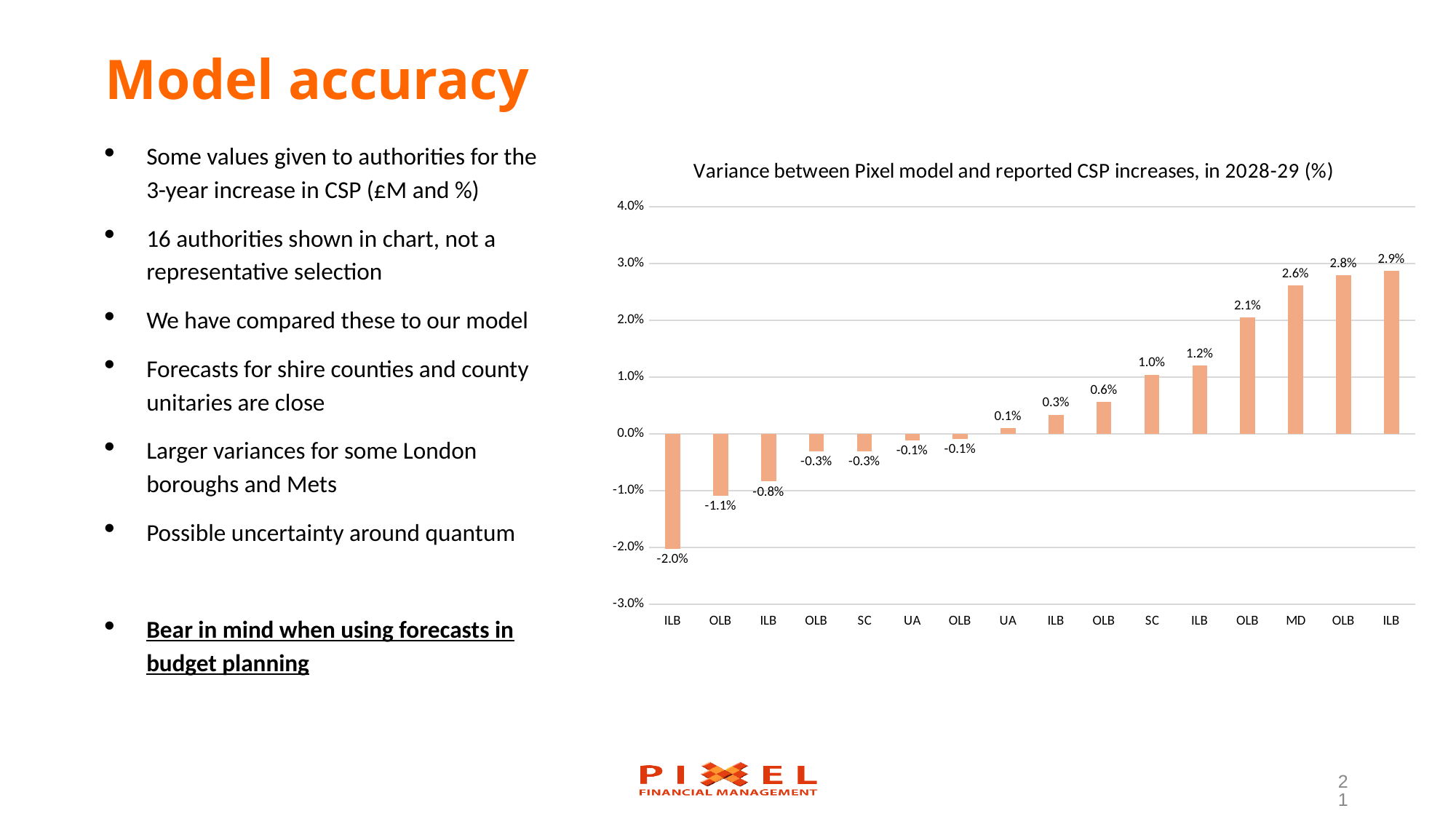
What is the value of the leftmost bar (ILB)? -2.0% What is the value of the MD bar? 2.6% Do the bar values rise or fall from left to right across the chart? rise How many bars in the chart have negative values? 7 How many bars are plotted in the chart? 16 What is the highest value shown in the chart? 2.9% What is the difference between the two SC bars (1.0% and -0.3%)? 1.3% What is the lowest value shown in the chart? -2.0% Which is larger: the MD bar or the OLB bar immediately to its right? the OLB bar (2.8%) What is the difference between the highest value (2.9%) and the lowest value (-2.0%) in the chart? 4.9% What is the title of the chart? Variance between Pixel model and reported CSP increases, in 2028-29 (%) What kind of chart is shown on the slide? bar chart